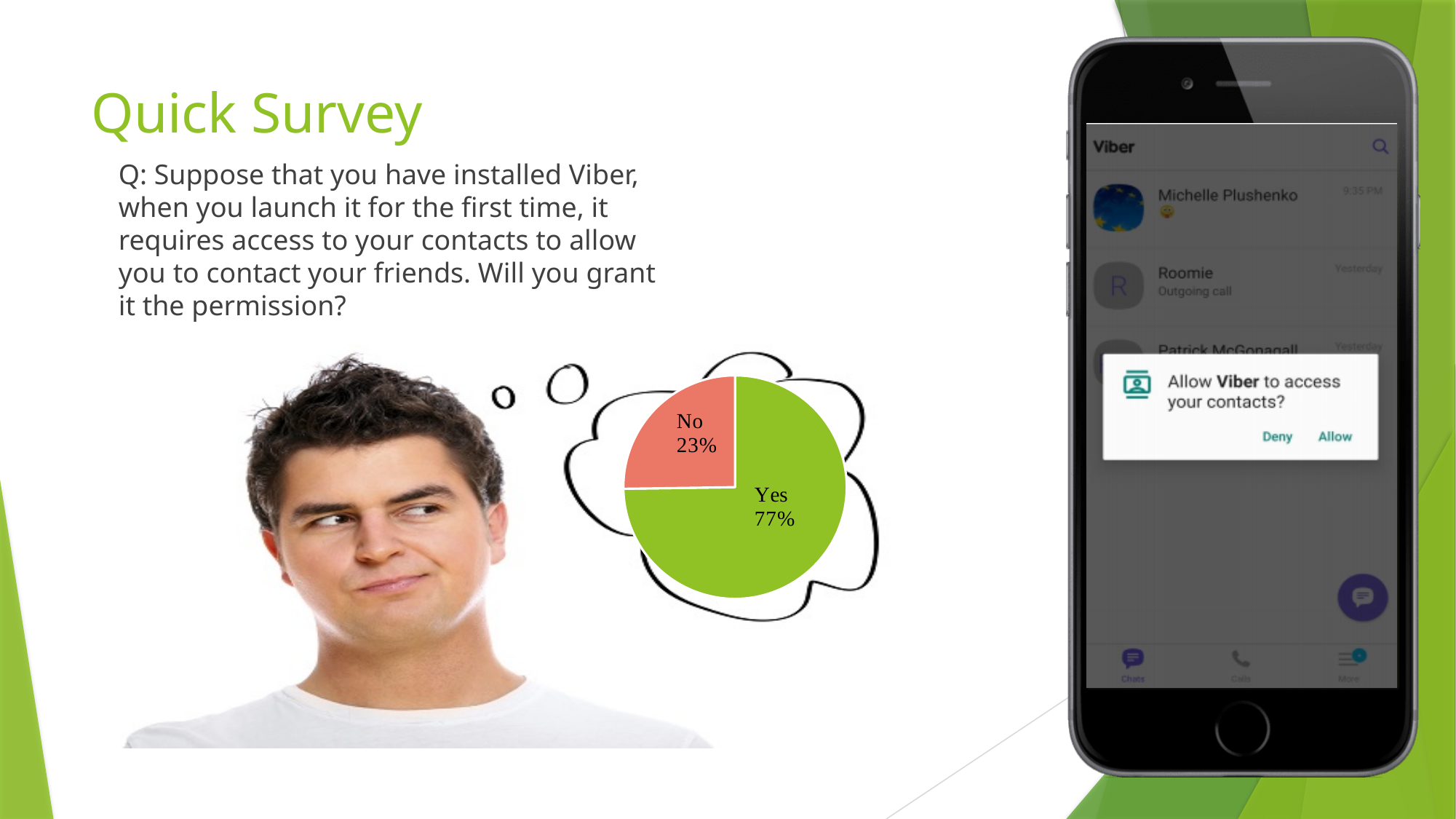
What share of the pie chart is labelled No? 23% Which slice of the pie chart is the smallest? No How many slices does the pie chart have? 2 Which slice is larger, Yes or No? Yes What share of the pie chart is labelled Yes? 77% Which slice of the pie chart is the largest? Yes What is the difference in percentage points between the Yes and No slices? 54 What colour is the Yes slice of the pie chart? green What is the total of the two slices shown in the pie chart? 100% What kind of chart is shown inside the thought bubble? pie chart What colour is the No slice of the pie chart? salmon/red